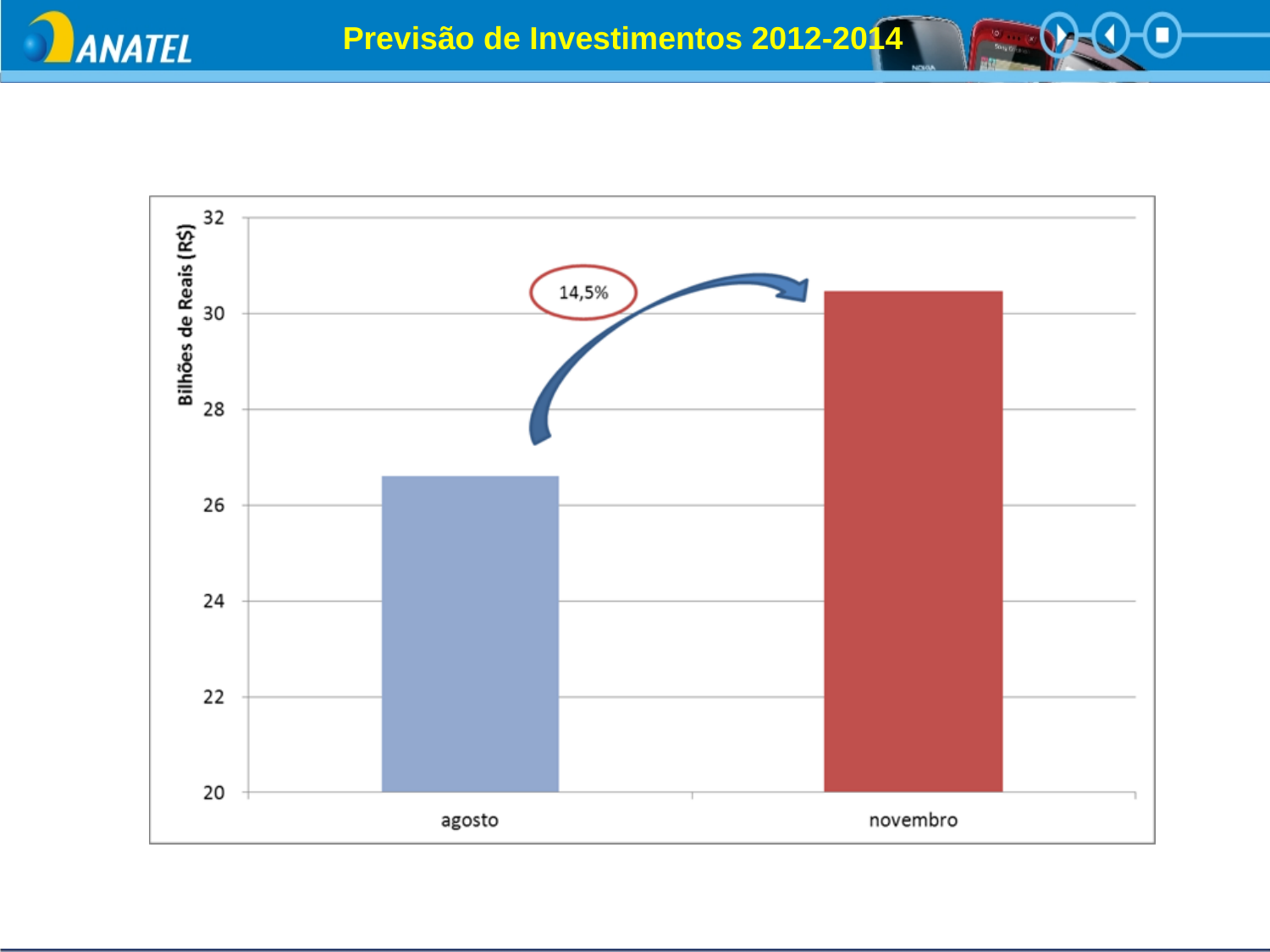
Is the value for novembro greater or less than 30? greater Is the value for agosto greater or less than 28? less Which category has the highest value in the chart? novembro Which category has the lowest value in the chart? agosto What kind of chart is shown on the slide? bar chart Is the value for agosto greater or less than 26? greater Which is larger, the value for agosto or the value for novembro? novembro What is the label of the vertical axis of the chart? Bilhões de Reais (R$) Do the values rise or fall from agosto to novembro? rise How many bars are plotted in the chart? 2 What percentage increase is annotated between the agosto and novembro bars? 14,5%